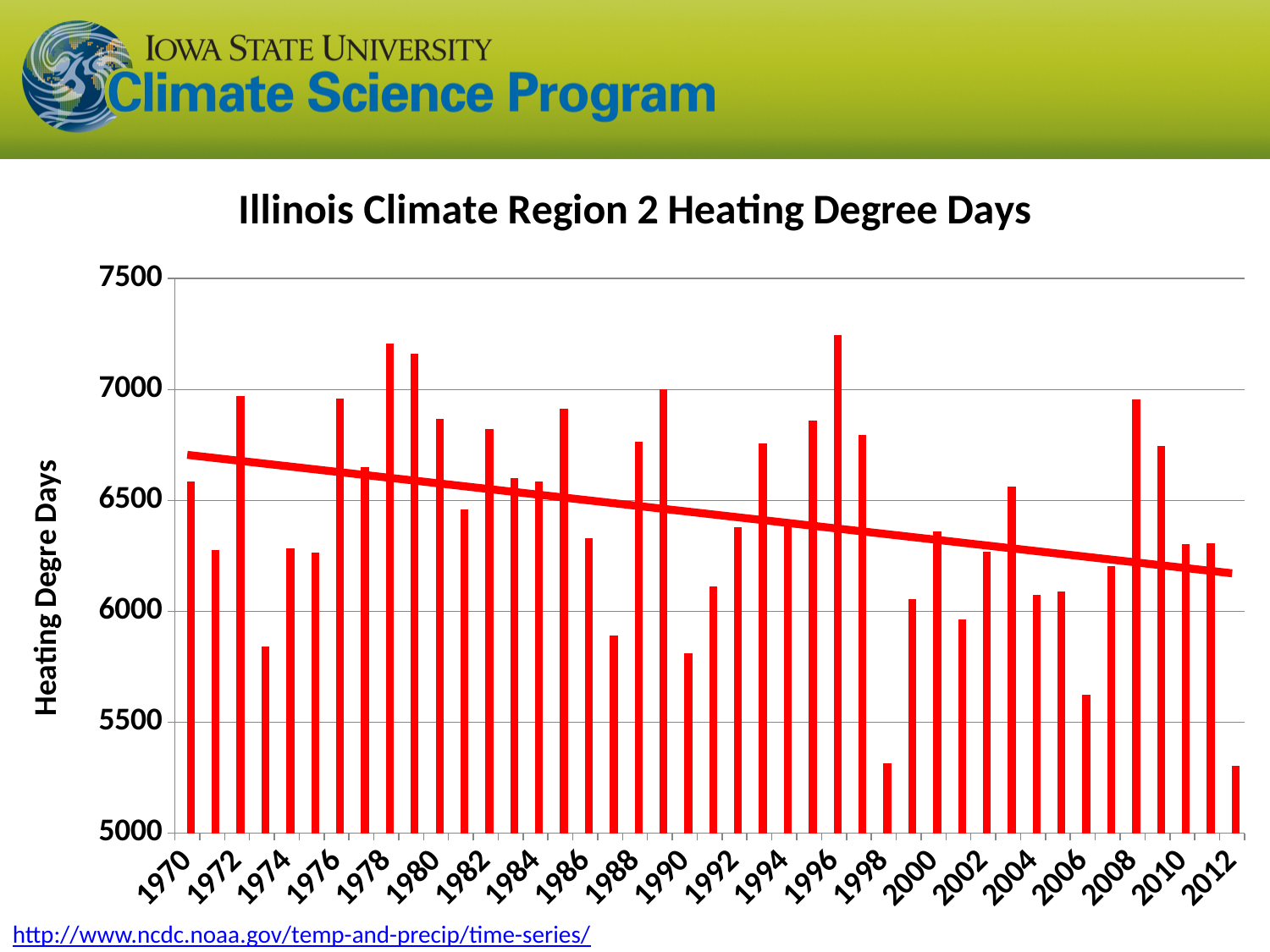
Which year has the larger value, 1978 or 1973? 1978 What is the title of the chart? Illinois Climate Region 2 Heating Degree Days Is the value for 1998 greater or less than 5500? less Is the value for 1978 greater or less than 7000? greater Is the value for 1973 greater or less than 6000? less Which year has the highest heating degree days value in the chart? 1996 Does the trend line in the chart rise or fall from 1970 to 2012? Fall What kind of chart is shown on the slide? Bar chart Which year has the larger value, 1998 or 1999? 1999 What is the label on the vertical axis of the chart? Heating Degre Days